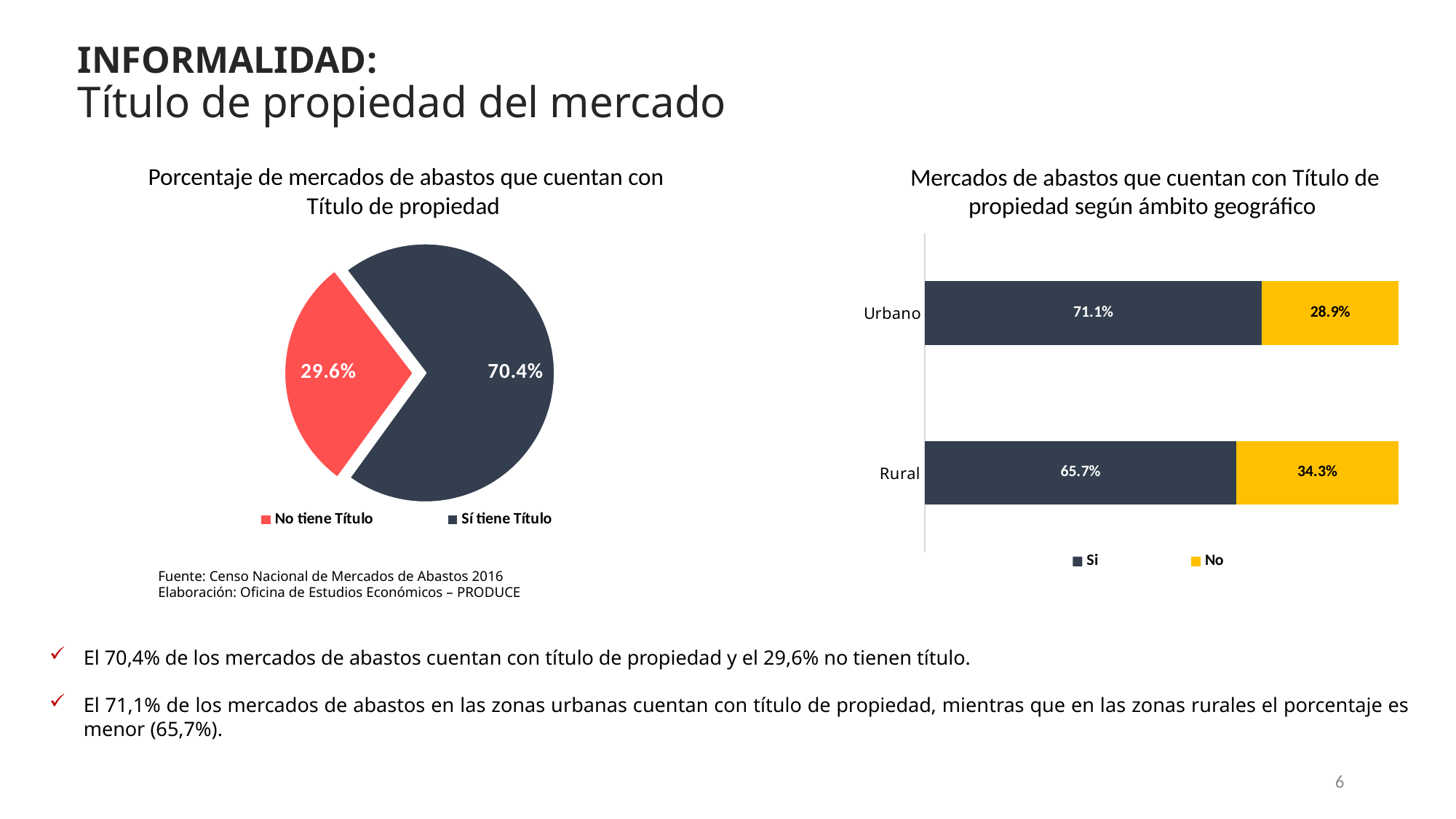
In the pie chart on the left, what percentage of markets have a property title (Sí tiene Título)? 70.4% In the bar chart on the right, what is the difference between the 'Si' values for Urbano and Rural? 5.4% In the pie chart on the left, which slice is larger, 'No tiene Título' or 'Sí tiene Título'? Sí tiene Título What kind of chart is the chart on the left? Pie chart In the bar chart on the right, how many series does the legend list? 2 In the bar chart on the right, what is the 'No' value for Rural? 34.3% In the pie chart on the left, what percentage of markets do not have a property title (No tiene Título)? 29.6% In the pie chart on the left, what is the difference between the 'Sí tiene Título' and 'No tiene Título' shares? 40.8% In the bar chart on the right, how many categories are shown on the vertical axis? 2 In the bar chart on the right, what is the 'Si' value for Urbano? 71.1% What kind of chart is the chart on the right, 'Mercados de abastos que cuentan con Título de propiedad según ámbito geográfico'? Bar chart In the bar chart on the right, which category has the higher 'Si' value, Urbano or Rural? Urbano